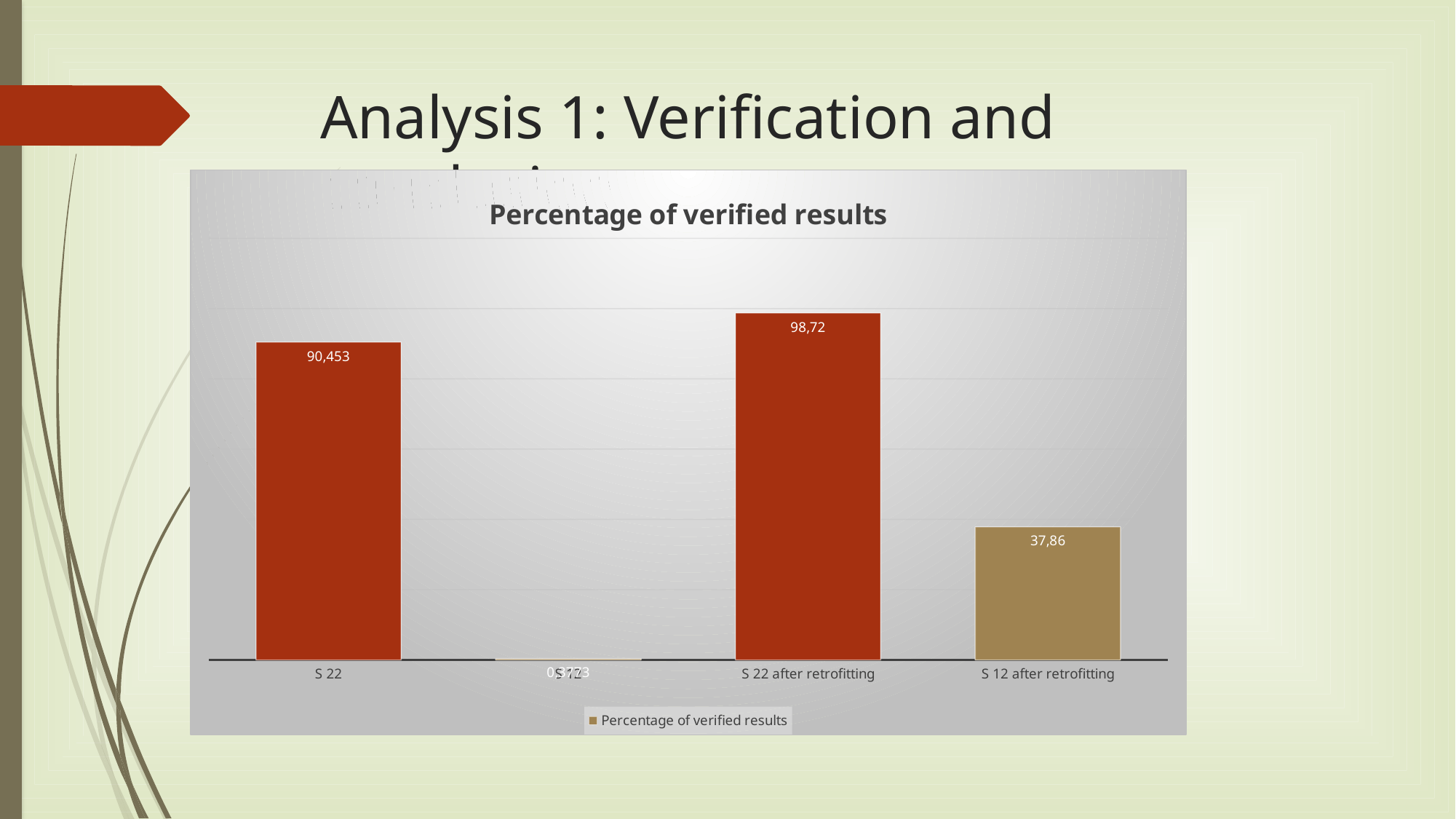
What type of chart is shown on the slide? Bar chart Which category has the lowest value? S 12 What is the difference between the values for S 22 after retrofitting and S 22? 8,267 What is the value for S 22? 90,453 What is the title of the chart? Percentage of verified results Which category has the highest value? S 22 after retrofitting What is the difference between the values for S 22 after retrofitting and S 12 after retrofitting? 60,86 What is the value for S 22 after retrofitting? 98,72 How many categories are shown on the x axis? 4 Which is larger, the value for S 22 or the value for S 22 after retrofitting? S 22 after retrofitting How many series does the legend list? 1 What is the value for S 12 after retrofitting? 37,86